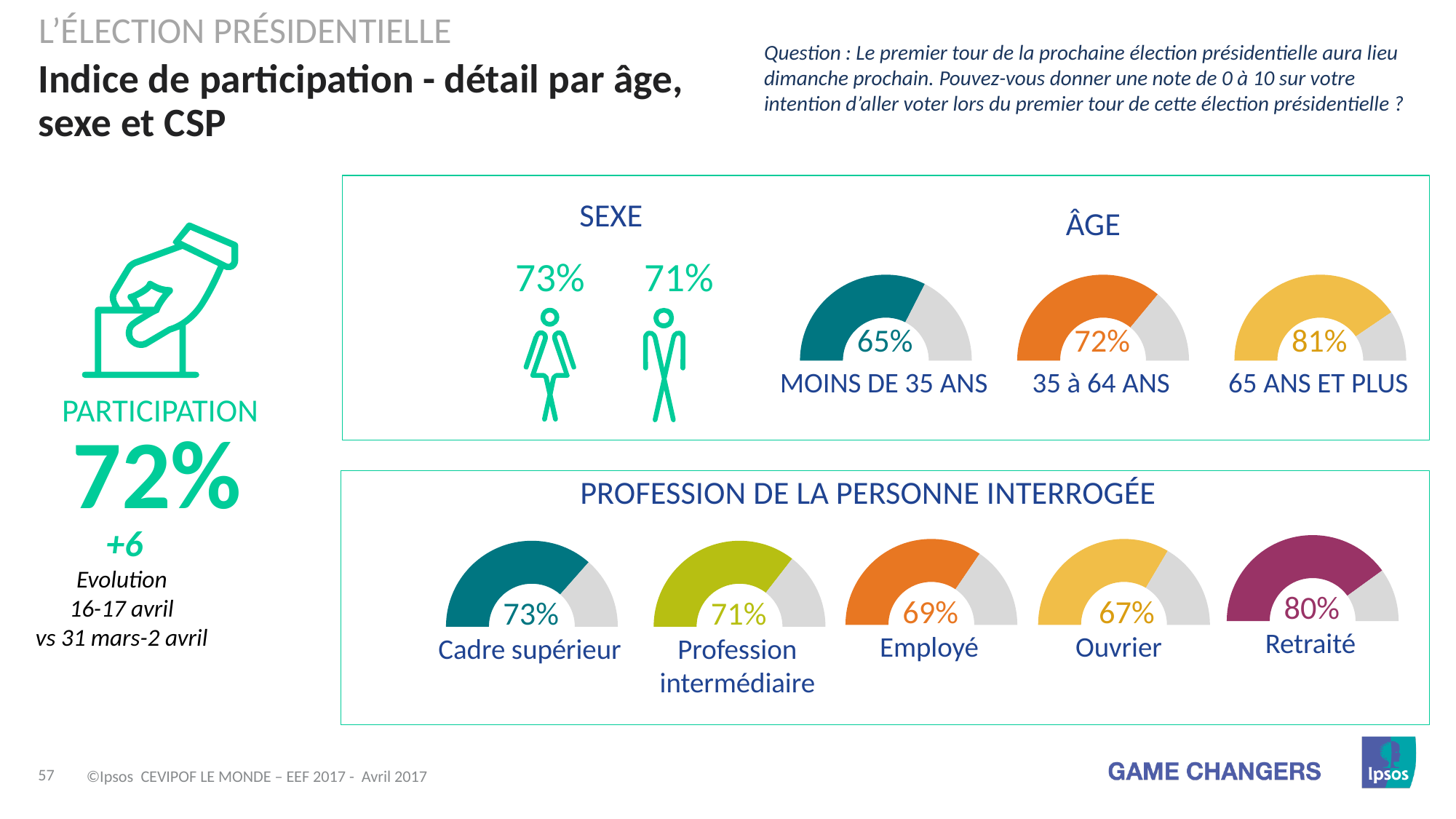
What kind of chart is used to show the values in the ÂGE and PROFESSION sections? Gauge (semi-circle donut) charts In the PROFESSION DE LA PERSONNE INTERROGÉE section, what is the difference between the values for 'Cadre supérieur' and 'Profession intermédiaire'? 2 percentage points In the PROFESSION DE LA PERSONNE INTERROGÉE section, what is the value shown for 'Retraité'? 80% In the ÂGE section, which age group has the highest value? 65 ANS ET PLUS In the ÂGE section, what is the value shown for 'MOINS DE 35 ANS'? 65% In the ÂGE section, what is the value shown for '65 ANS ET PLUS'? 81% In the ÂGE section, what is the difference between the values for '65 ANS ET PLUS' and 'MOINS DE 35 ANS'? 16 percentage points In the PROFESSION DE LA PERSONNE INTERROGÉE section, how many profession categories are shown? 5 In the PROFESSION DE LA PERSONNE INTERROGÉE section, which category has the lowest value? Ouvrier In the PROFESSION DE LA PERSONNE INTERROGÉE section, what is the value shown for 'Ouvrier'? 67% In the PROFESSION DE LA PERSONNE INTERROGÉE section, which is larger: the value for 'Cadre supérieur' or the value for 'Employé'? Cadre supérieur In the PROFESSION DE LA PERSONNE INTERROGÉE section, which category has the highest value? Retraité